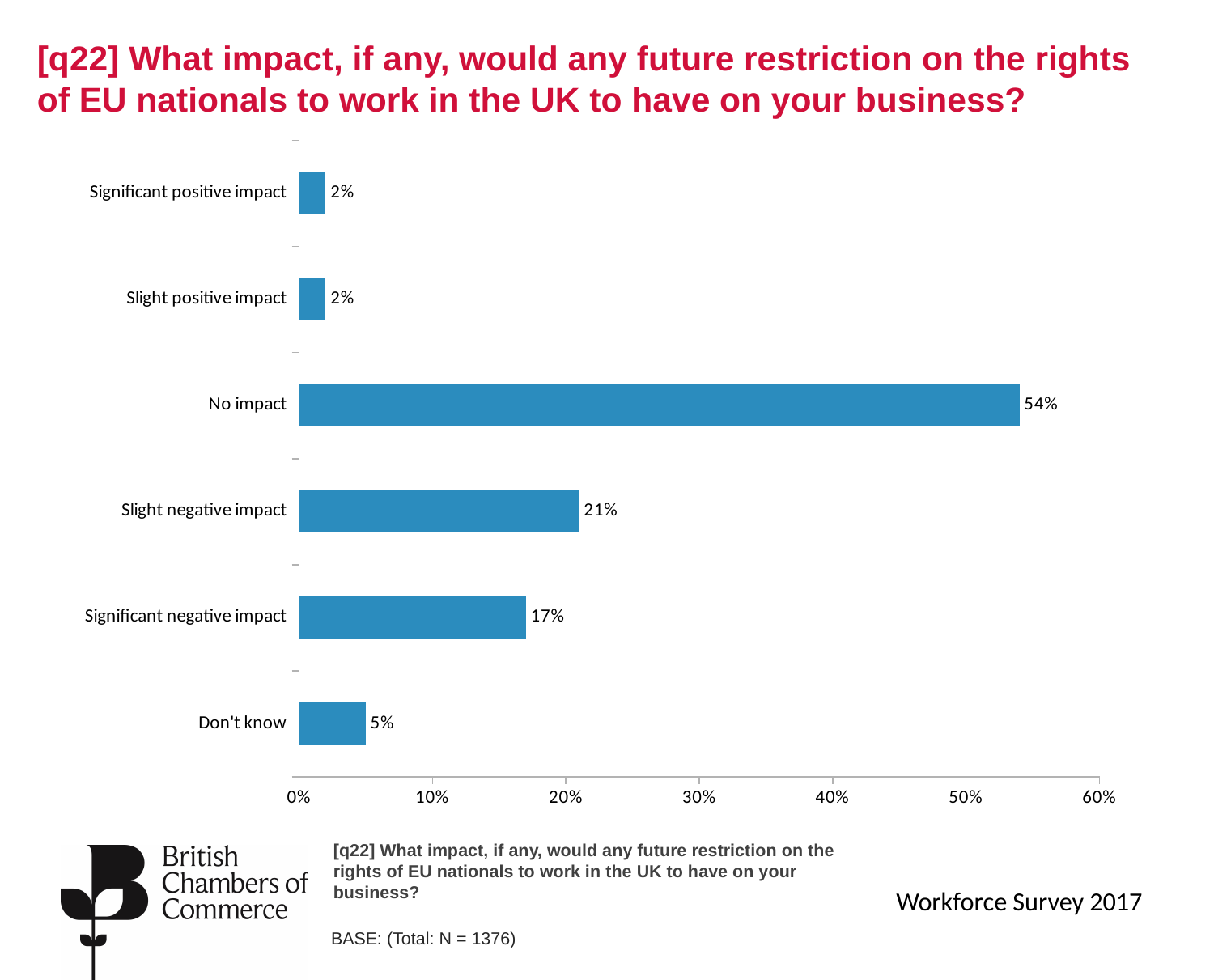
What percentage of respondents said a future restriction would have no impact on their business? 54% What is the difference between 'Slight negative impact' and 'Significant negative impact'? 4% Which is larger, the value for 'Don't know' or the value for 'Slight positive impact'? Don't know What is the value for 'Slight negative impact'? 21% What is the base size (N) stated on the slide? 1376 What is the value for 'Significant negative impact'? 17% Which response category has the highest value? No impact What percentage of respondents answered 'Don't know'? 5% Is the value for 'No impact' greater or less than 50%? greater What kind of chart is shown on the slide? Bar chart What is the difference between 'No impact' and 'Slight negative impact'? 33% How many response categories are shown in the chart? 6